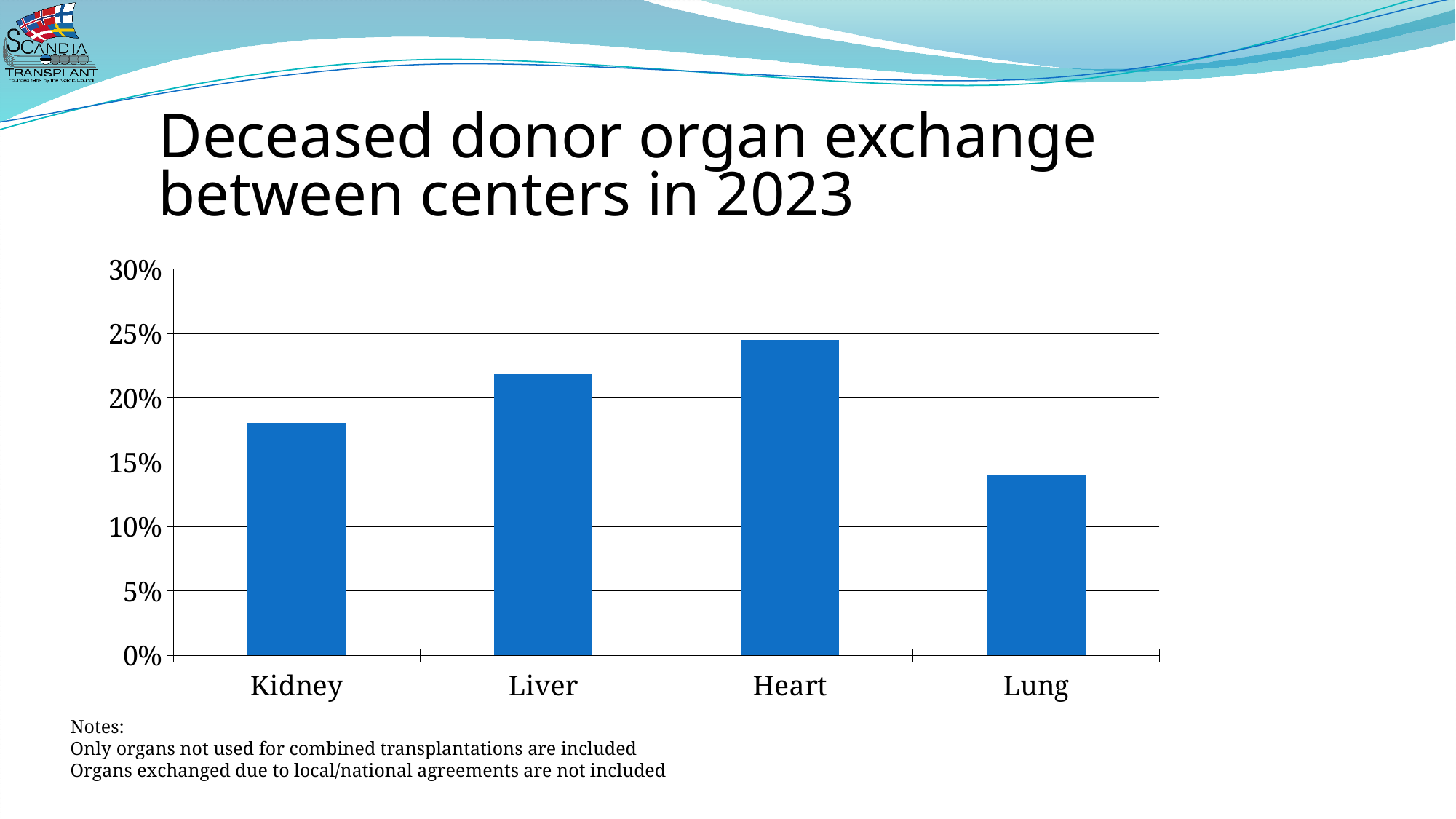
What kind of chart is shown on the slide? bar chart Which is larger, the value for Liver or the value for Kidney? Liver What is the title of the slide containing the chart? Deceased donor organ exchange between centers in 2023 Is the value for Kidney greater or less than 20%? less Is the value for Lung greater or less than 15%? less Is the value for Liver greater or less than 20%? greater Which organ has the lowest exchange percentage? Lung Which organ has the highest exchange percentage? Heart Which is larger, the value for Lung or the value for Heart? Heart How many organ categories are shown on the x axis? 4